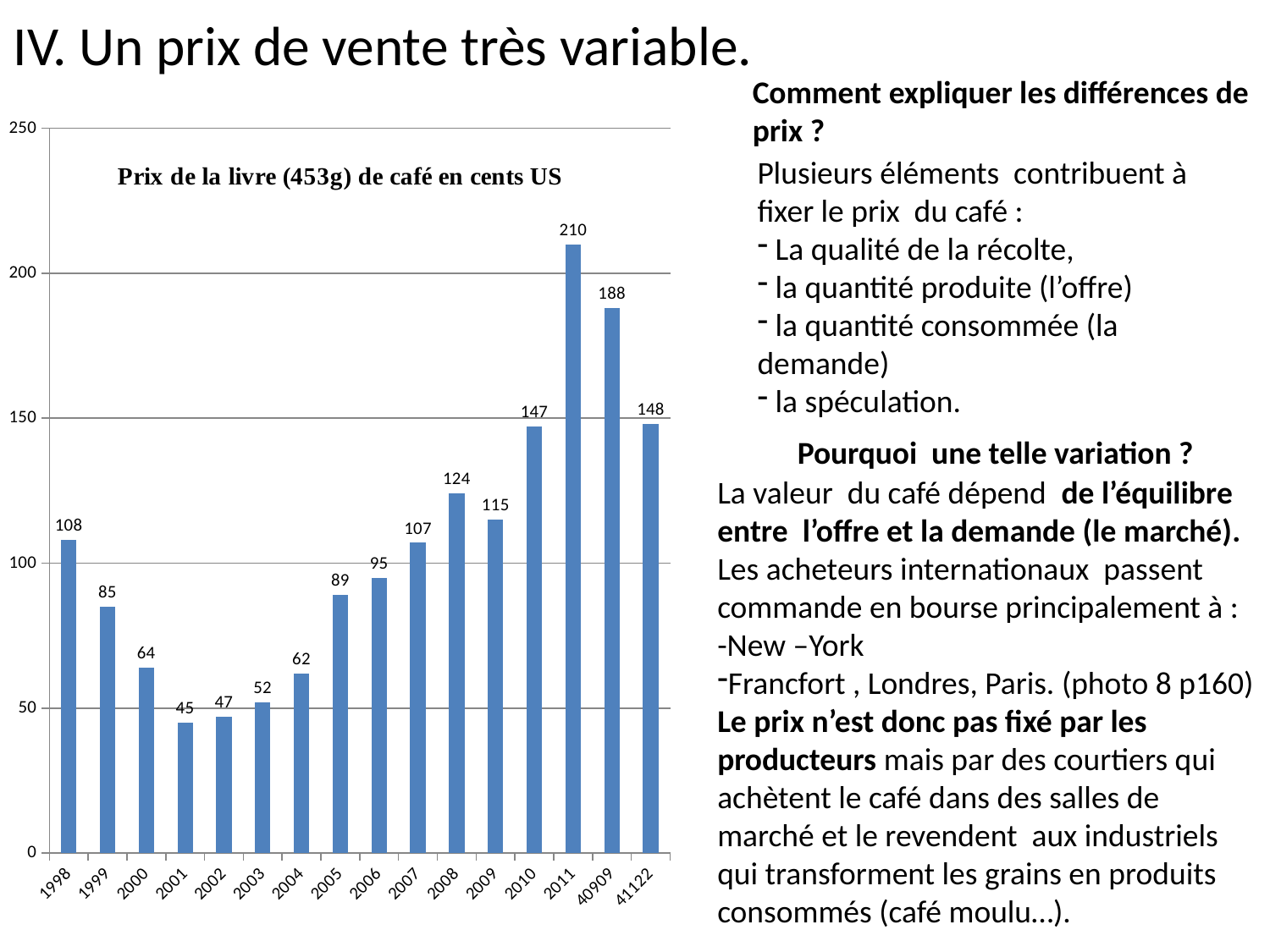
Which category has the highest value? 2011 How many categories are shown on the x axis? 16 What kind of chart is shown on the slide? bar chart Do the values rise or fall from 2001 to 2008? rise What is the value for 2008? 124 What is the value for 2011? 210 Is the value for 2005 greater or less than 100? less Which category has the lowest value? 2001 What is the title of the chart? Prix de la livre (453g) de café en cents US What is the difference between the values for 2011 and 2010? 63 What is the value for 2001? 45 Which is larger, the value for 2008 or the value for 2009? 2008